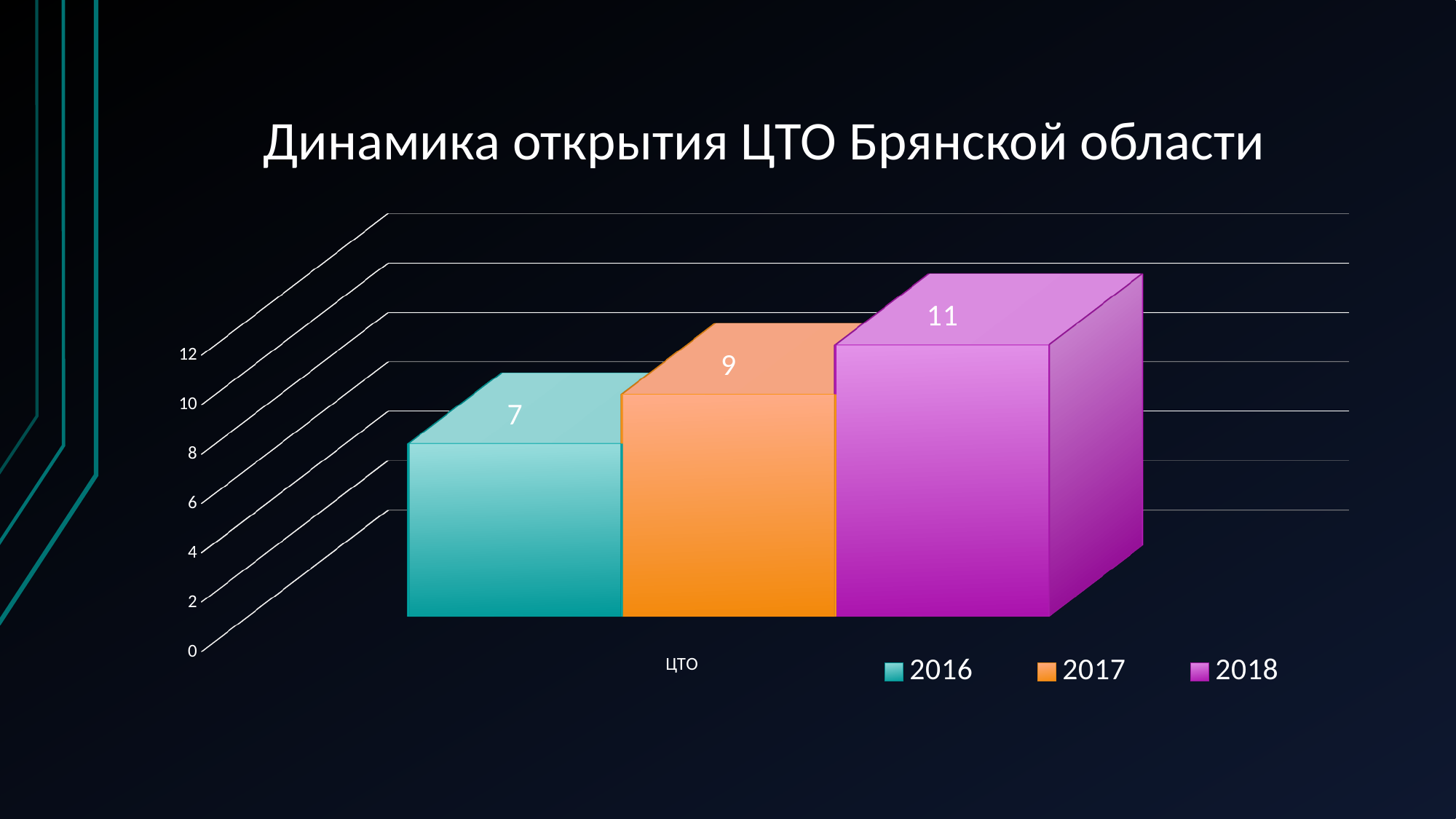
What is the title of the chart? Динамика открытия ЦТО Брянской области What is the value for 2018? 11 Is the value for 2018 greater or less than 10? greater What kind of chart is shown on the slide? bar chart What is the difference between the values for 2017 and 2016? 2 What is the difference between the values for 2018 and 2016? 4 Which is larger, the value for 2017 or the value for 2018? 2018 How many series does the legend list? 3 What is the value for 2016? 7 Which year has the highest value? 2018 Which year has the lowest value? 2016 What is the value for 2017? 9